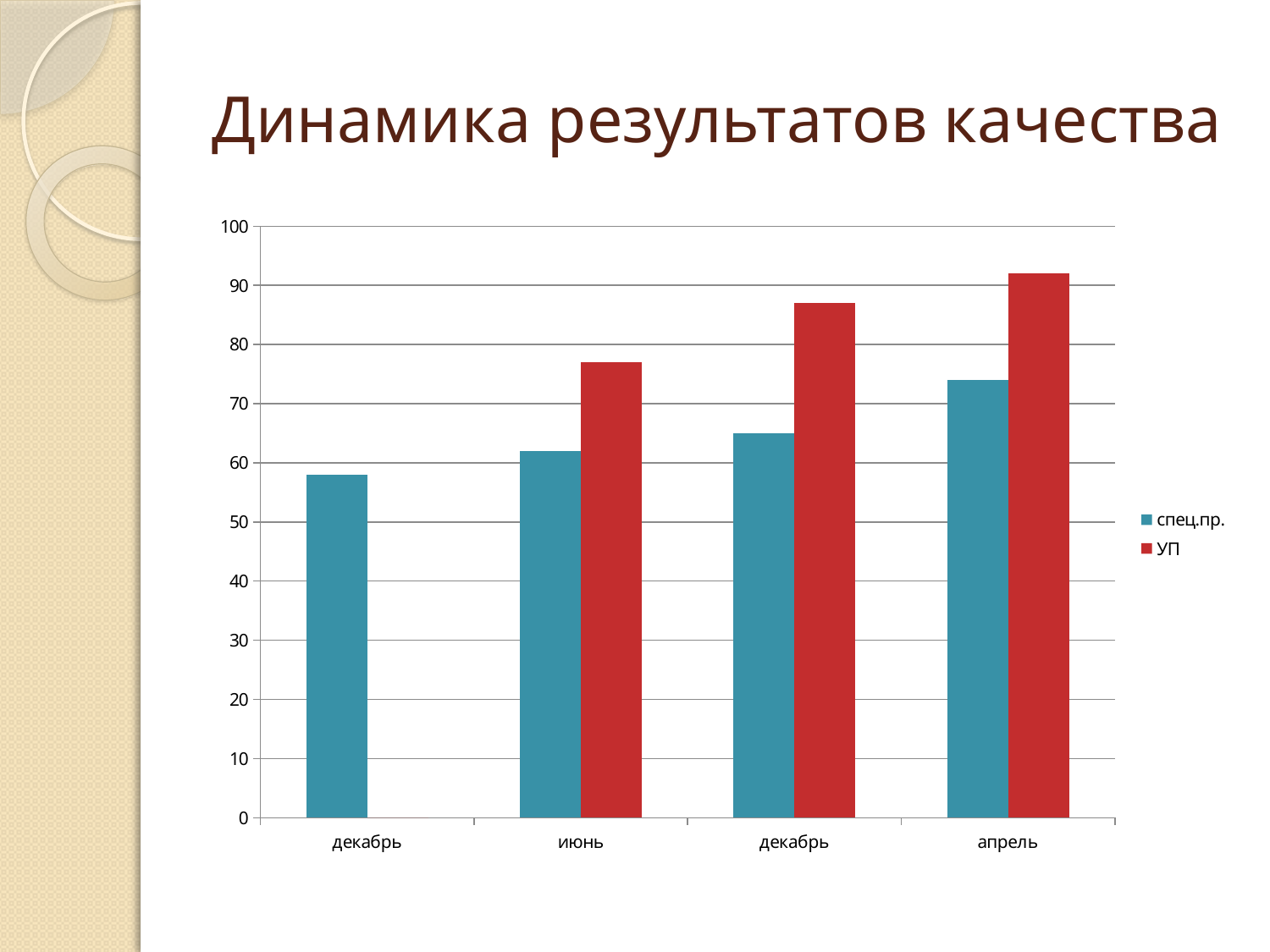
Which category has the highest value for УП? апрель Which category has the lowest value for спец.пр.? декабрь (the first one) Is the value for УП in апрель greater or less than 90? greater Is the value for УП in июнь greater or less than 80? less How many series does the legend list? 2 Is the value for спец.пр. in the first декабрь greater or less than 50? greater Which series is shown in red in the legend? УП Do the values for спец.пр. rise or fall from left to right along the x axis? rise What is the title of the slide above the chart? Динамика результатов качества What kind of chart is shown on the slide? bar chart How many categories are shown on the x axis? 4